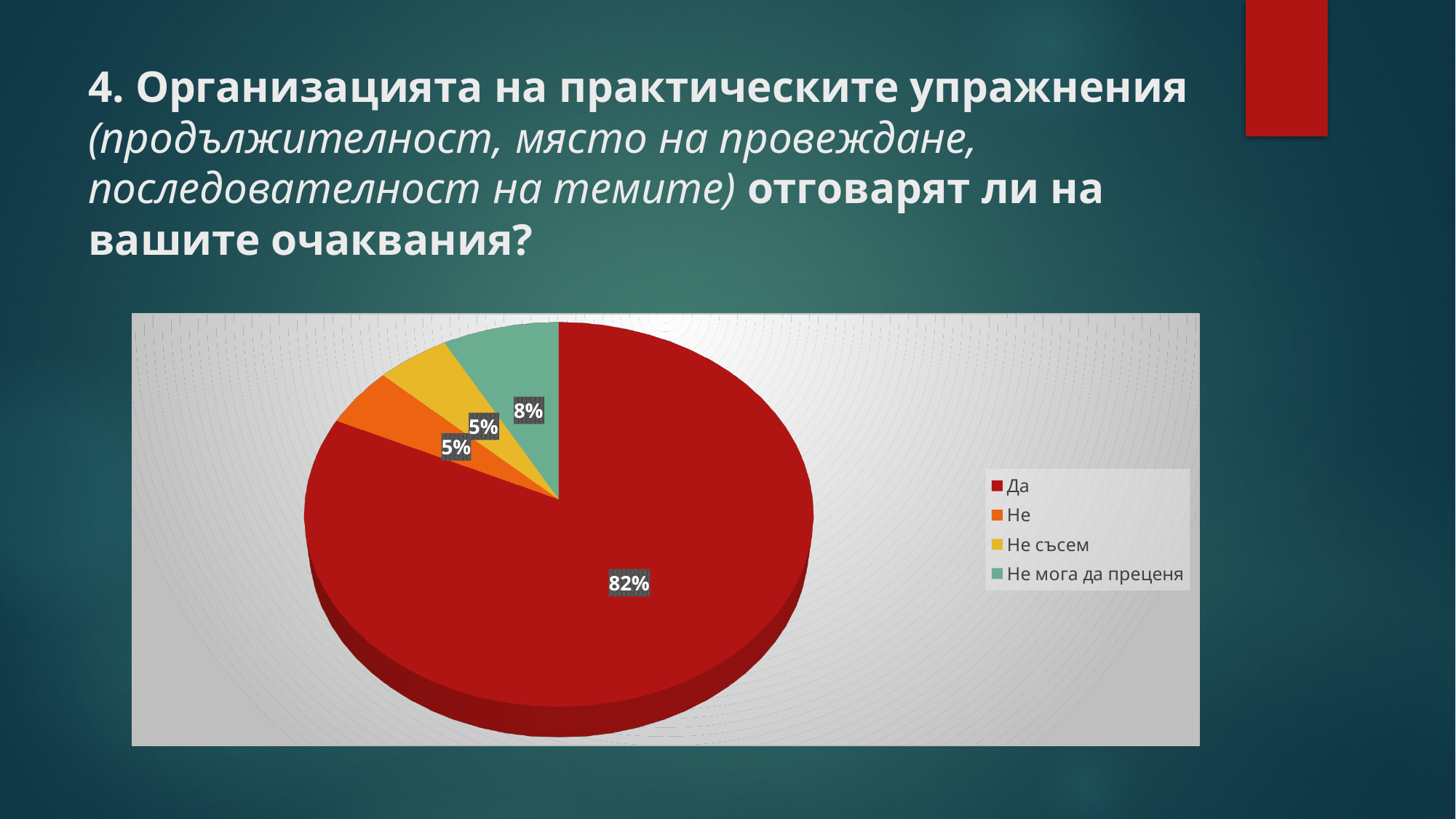
What is the value shown for the "Не" slice? 5% How many entries does the legend list? 4 What is the difference between the "Да" share and the "Не мога да преценя" share? 74% What is the difference between the "Не мога да преценя" share and the "Не" share? 3% How many slices does the pie chart have? 4 Which category has the largest slice of the pie? Да What colour is the "Да" slice in the pie chart? red What share of the pie does the "Не мога да преценя" slice represent? 8% What share of the pie does the "Да" slice represent? 82% Which is larger, the "Да" slice or the "Не мога да преценя" slice? Да What kind of chart is shown on the slide? pie chart